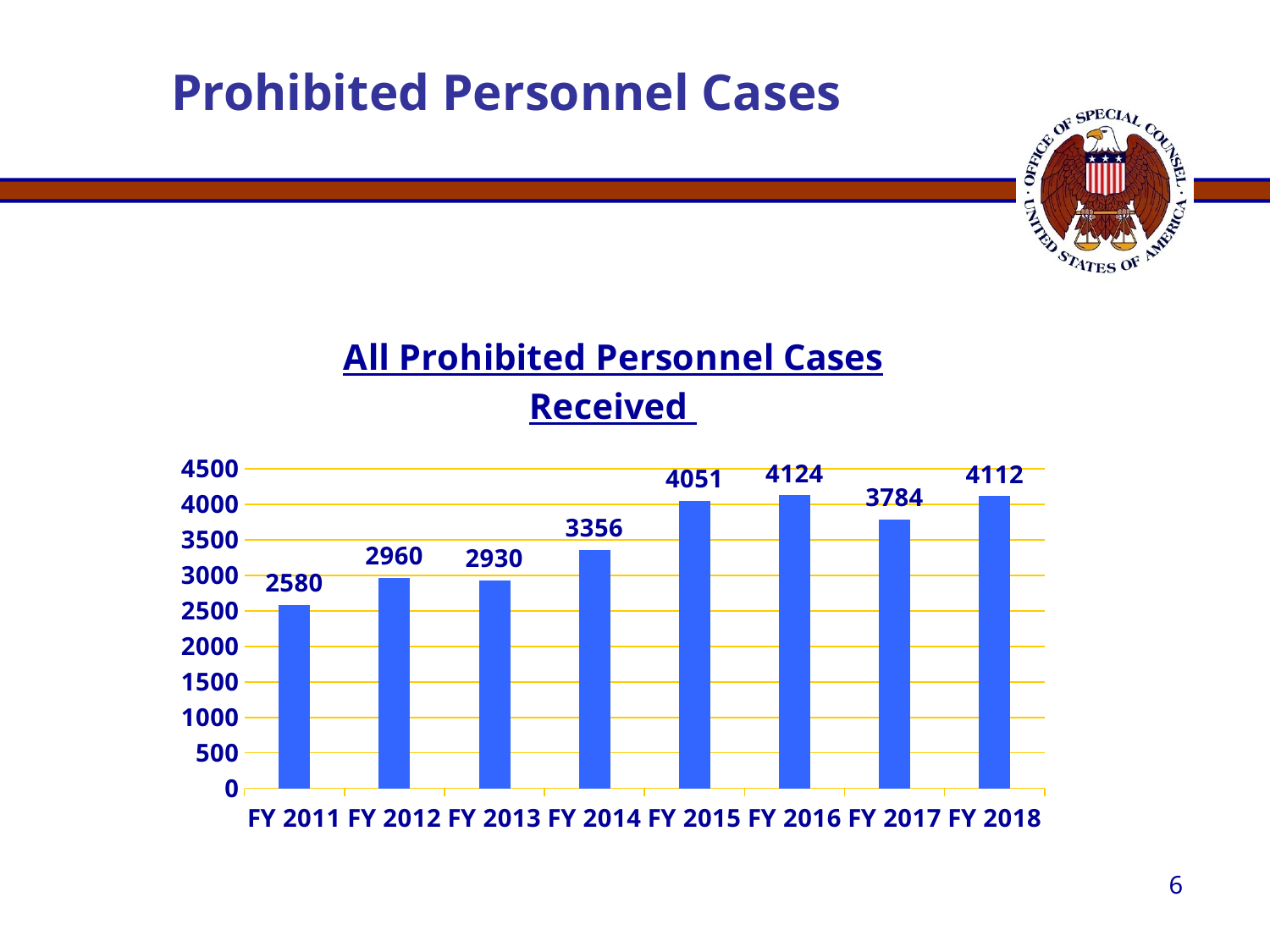
What kind of chart is shown on the slide? Bar chart What is the value for FY 2011? 2580 What is the difference between the values for FY 2018 and FY 2017? 328 What is the difference between the values for FY 2016 and FY 2011? 1544 Which fiscal year has the lowest number of cases received? FY 2011 Which is larger, the value for FY 2012 or the value for FY 2013? FY 2012 Which fiscal year has the highest number of cases received? FY 2016 Is the value for FY 2015 greater or less than 4000? greater How many fiscal years are shown on the chart? 8 What is the title of the chart? All Prohibited Personnel Cases Received What is the value for FY 2014? 3356 What is the value for FY 2017? 3784